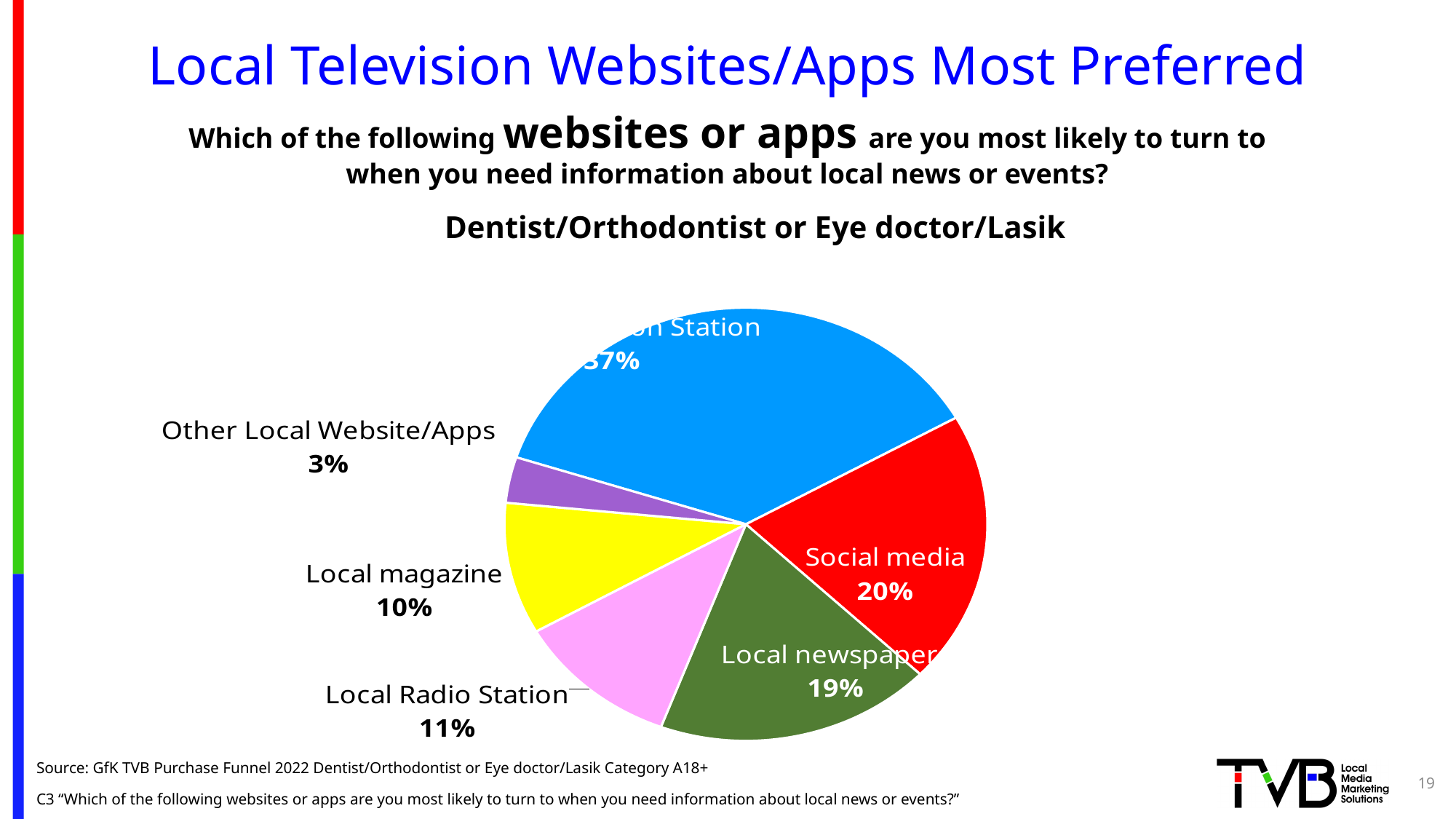
What percentage is shown for Local Radio Station? 11% What percentage of respondents chose Social media? 20% How many slices does the pie chart have? 6 What type of chart is shown on the slide? Pie chart What is the difference in percentage points between Social media and Local magazine? 10% Which labeled category has the smallest share of the pie? Other Local Website/Apps Which is larger, Social media or Local newspaper? Social media What percentage is shown for Local newspaper? 19% What is the difference in percentage points between Local Radio Station and Local magazine? 1% What colour is the Social media slice? Red What percentage is shown for Other Local Website/Apps? 3% What percentage is shown for Local magazine? 10%